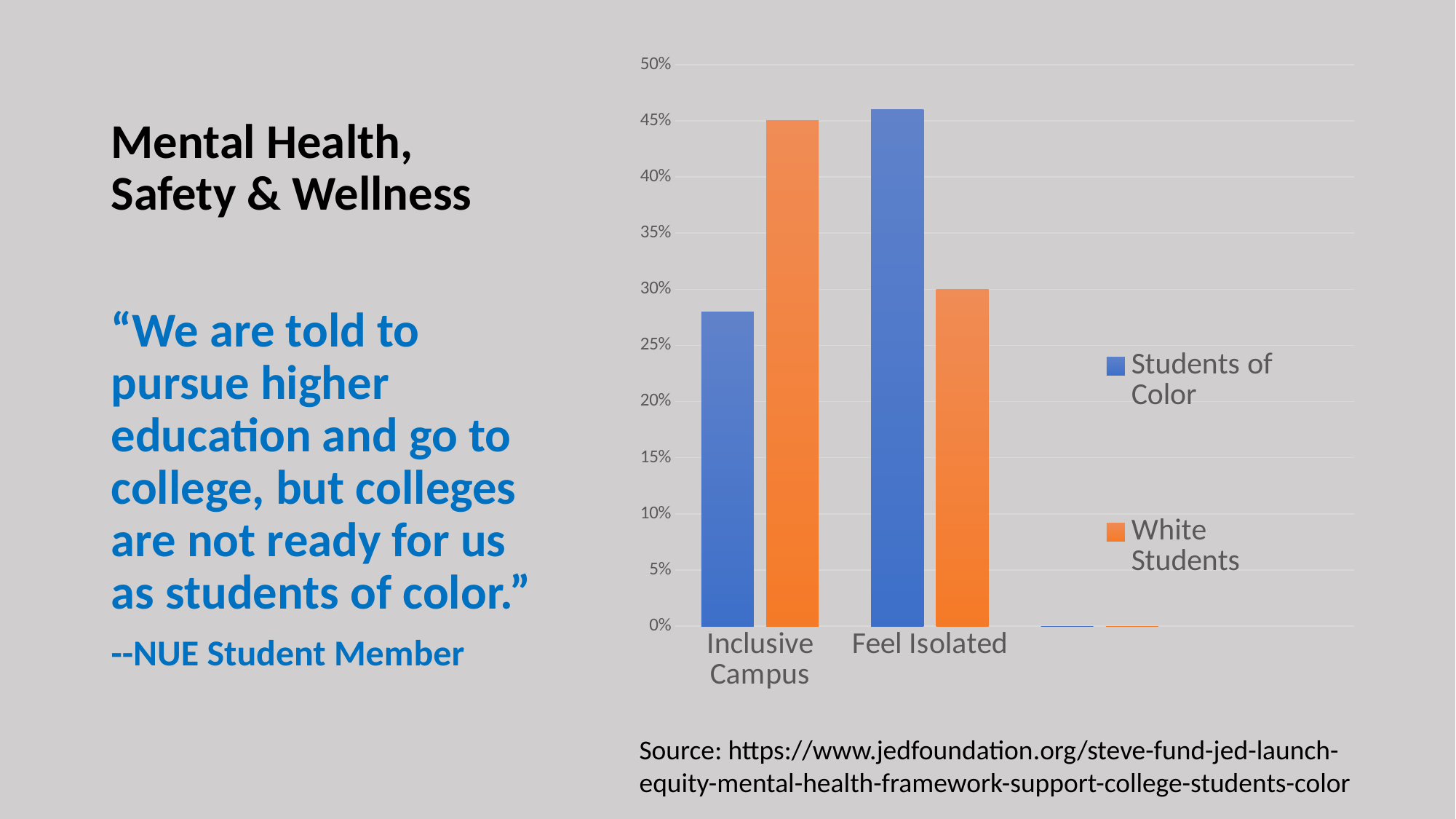
What kind of chart is shown on the slide? bar chart Is the value for Students of Color in the Inclusive Campus category greater or less than 30%? less In the Feel Isolated category, which series has the larger value, Students of Color or White Students? Students of Color What is the value for White Students in the Inclusive Campus category? 45% What is the value for White Students in the Feel Isolated category? 30% For the Students of Color series, which category has the higher value? Feel Isolated In the Inclusive Campus category, which series has the larger value, Students of Color or White Students? White Students Which colour represents the White Students series in the chart? orange What are the two series named in the chart legend? Students of Color and White Students How many series does the chart legend list? 2 Is the value for Students of Color in the Feel Isolated category greater or less than 45%? greater How many labelled categories are shown on the x axis of the chart? 2